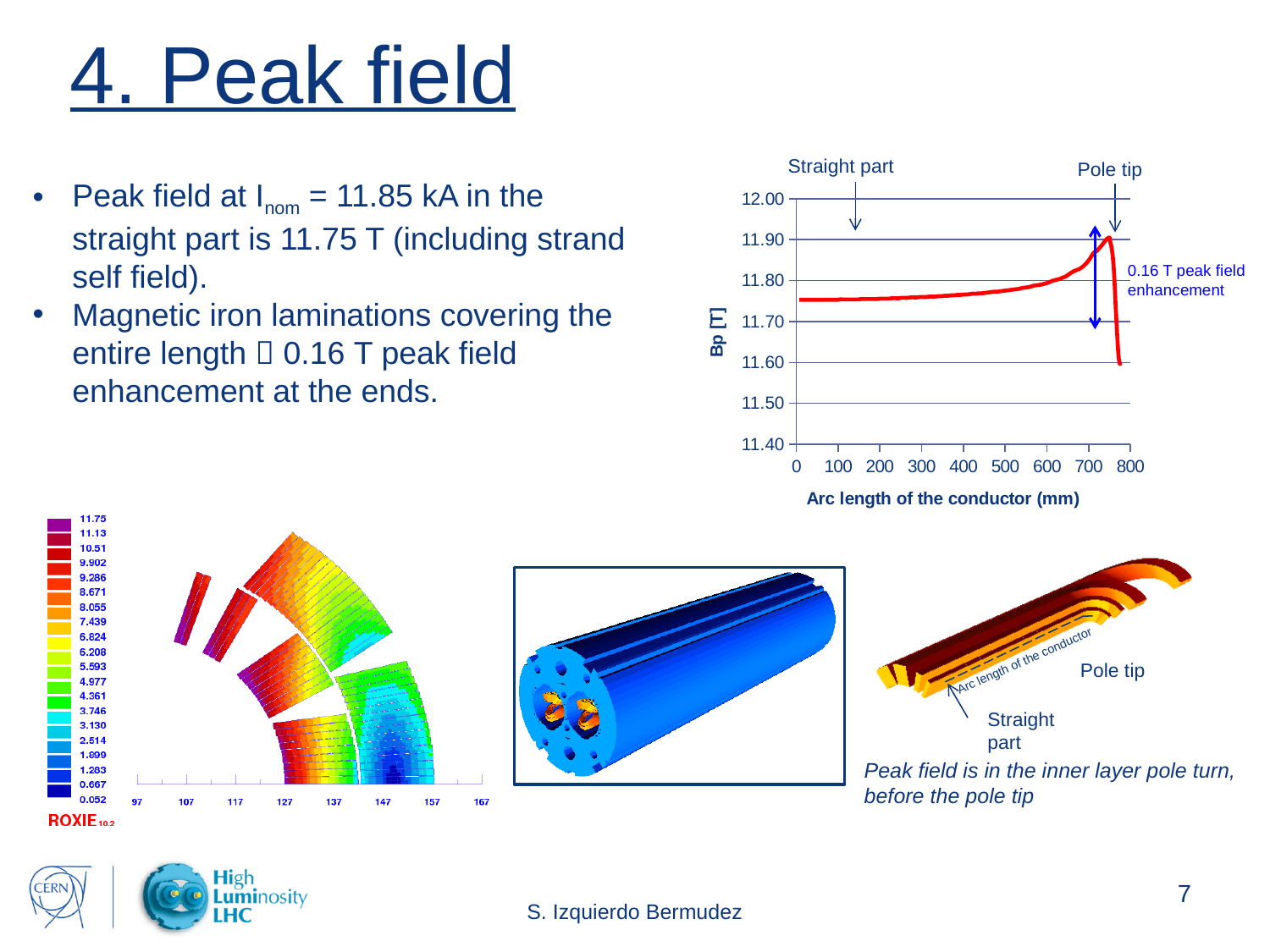
In the line chart, is the peak value of Bp greater or less than 11.80? greater What is the label of the x axis of the line chart? Arc length of the conductor (mm) What is the highest tick value shown on the y axis of the line chart? 12.00 In the line chart, is the value of Bp at the very end of the curve (after the pole tip) greater or less than 11.70? less In the line chart, is the value of Bp at an arc length of 700 mm greater or less than 11.80? greater What kind of chart is the Bp [T] versus arc length chart? line chart What peak field enhancement is annotated on the line chart near the pole tip? 0.16 T What is the label of the y axis of the line chart? Bp [T] How many lines (series) are plotted in the Bp [T] chart? 1 In the line chart, is Bp at 700 mm larger or smaller than Bp at 100 mm? larger In the line chart, does Bp rise or fall as the arc length increases from 0 mm to 700 mm? rise